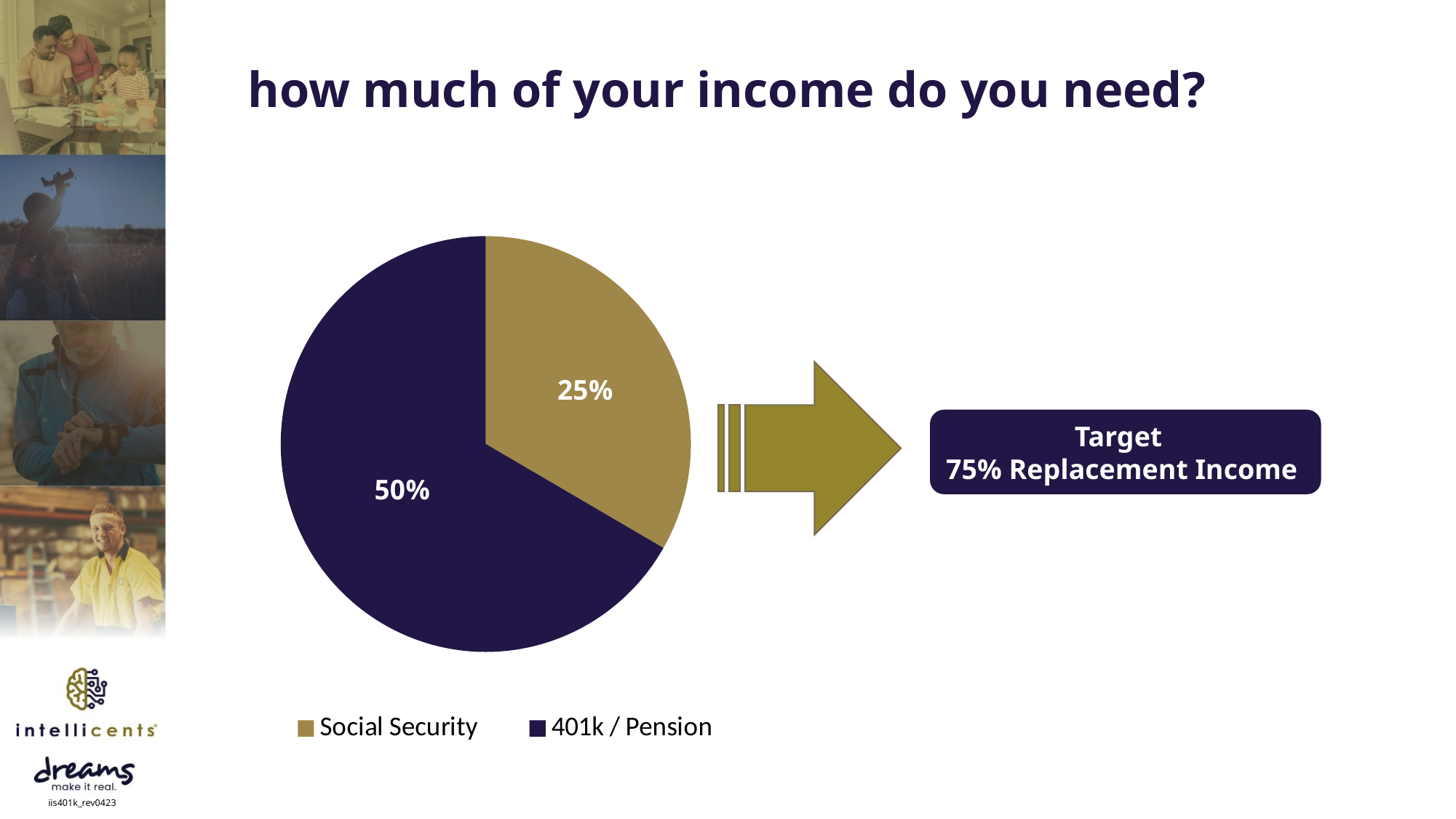
What colour is the Social Security slice in the pie chart? gold What is the title of the slide containing the pie chart? how much of your income do you need? How many slices does the pie chart have? 2 Which slice of the pie chart has the largest labelled value? 401k / Pension Which slice of the pie chart has the smallest labelled value? Social Security How many entries does the legend of the pie chart list? 2 What value is labelled on the Social Security slice of the pie chart? 25% What is the difference between the labelled values for 401k / Pension and Social Security? 25% What value is labelled on the 401k / Pension slice of the pie chart? 50% What kind of chart is shown on the slide? pie chart Which is larger in the pie chart, Social Security or 401k / Pension? 401k / Pension